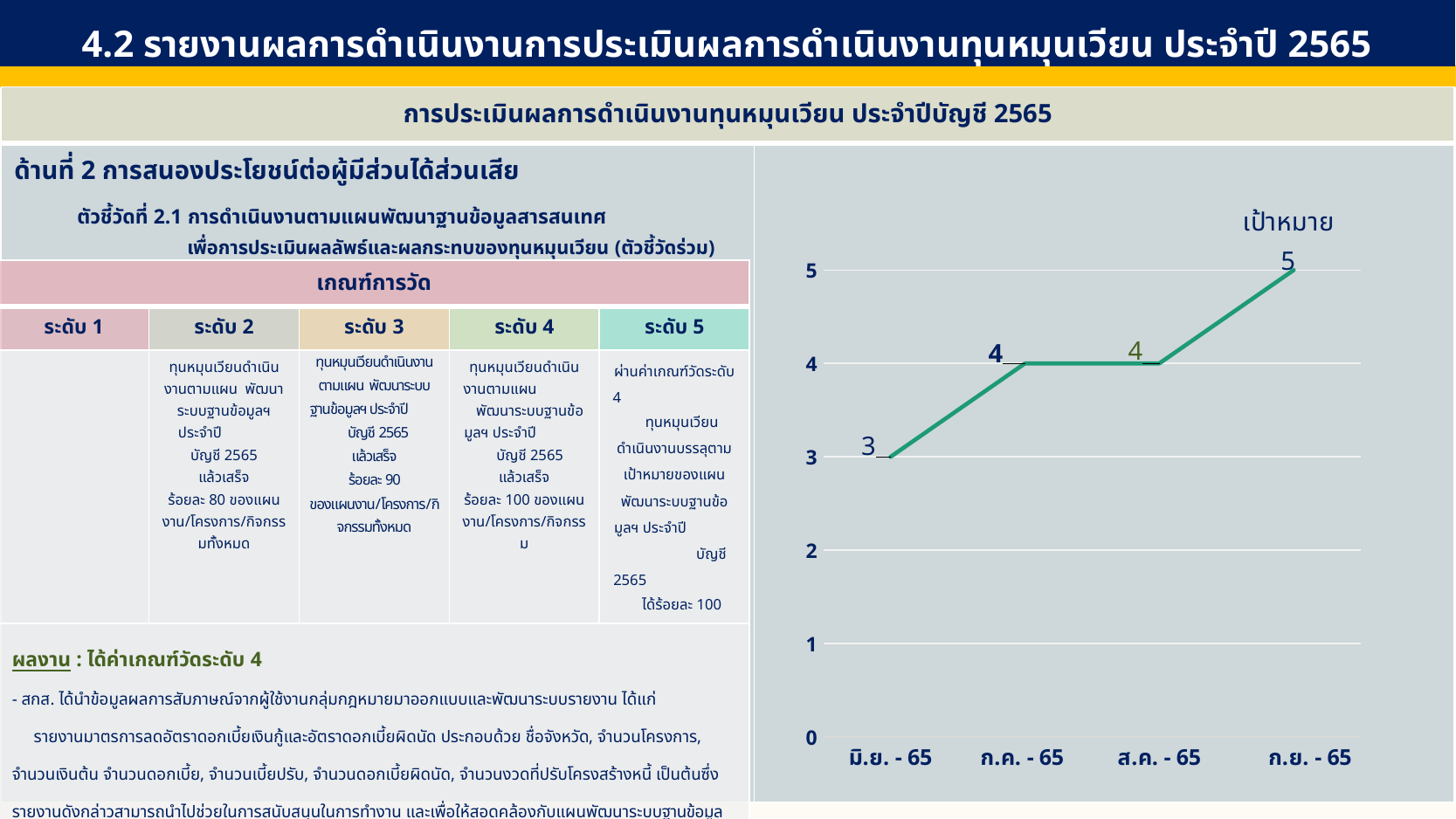
What is the value for มิ.ย. - 65 in the line chart? 3 What is the value for ก.ค. - 65 in the line chart? 4 What type of chart is shown on the right side of the slide? line chart What is the difference between the values for ก.ย. - 65 and มิ.ย. - 65 in the line chart? 2 What is the value for ก.ย. - 65 in the line chart? 5 Which month has the lowest value in the line chart? มิ.ย. - 65 Which month has the highest value in the line chart? ก.ย. - 65 What label appears above the line near the top right of the chart? เป้าหมาย Do the values in the line chart rise or fall from มิ.ย. - 65 to ก.ย. - 65? rise Which is larger in the line chart, the value for ก.ค. - 65 or the value for ก.ย. - 65? ก.ย. - 65 What is the value for ส.ค. - 65 in the line chart? 4 How many data points are plotted in the line chart? 4